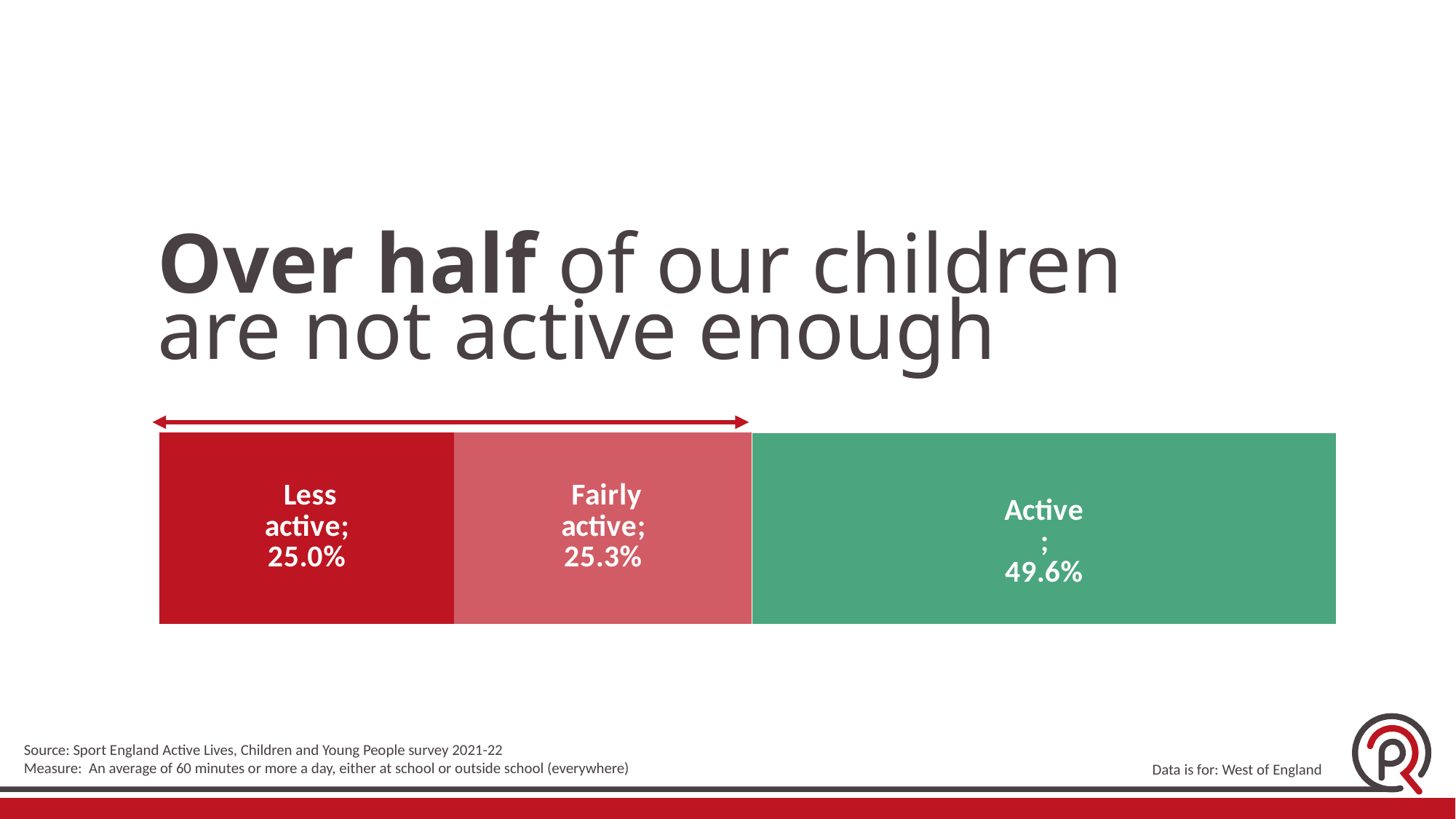
How many categories are shown in the bar? 3 What percentage of children are shown as 'Active'? 49.6% What kind of chart is shown on the slide? stacked bar chart Is the 'Active' share larger or smaller than the 'Fairly active' share? larger What is the combined share of 'Less active' and 'Fairly active' children? 50.3% What colour is the 'Active' segment of the bar? green What percentage of children are shown as 'Fairly active'? 25.3% What is the difference between the 'Active' share and the 'Less active' share? 24.6% Which region does the slide say the data is for? West of England What percentage of children are shown as 'Less active'? 25.0% Which category has the smallest share in the bar? Less active Which category has the largest share in the bar? Active